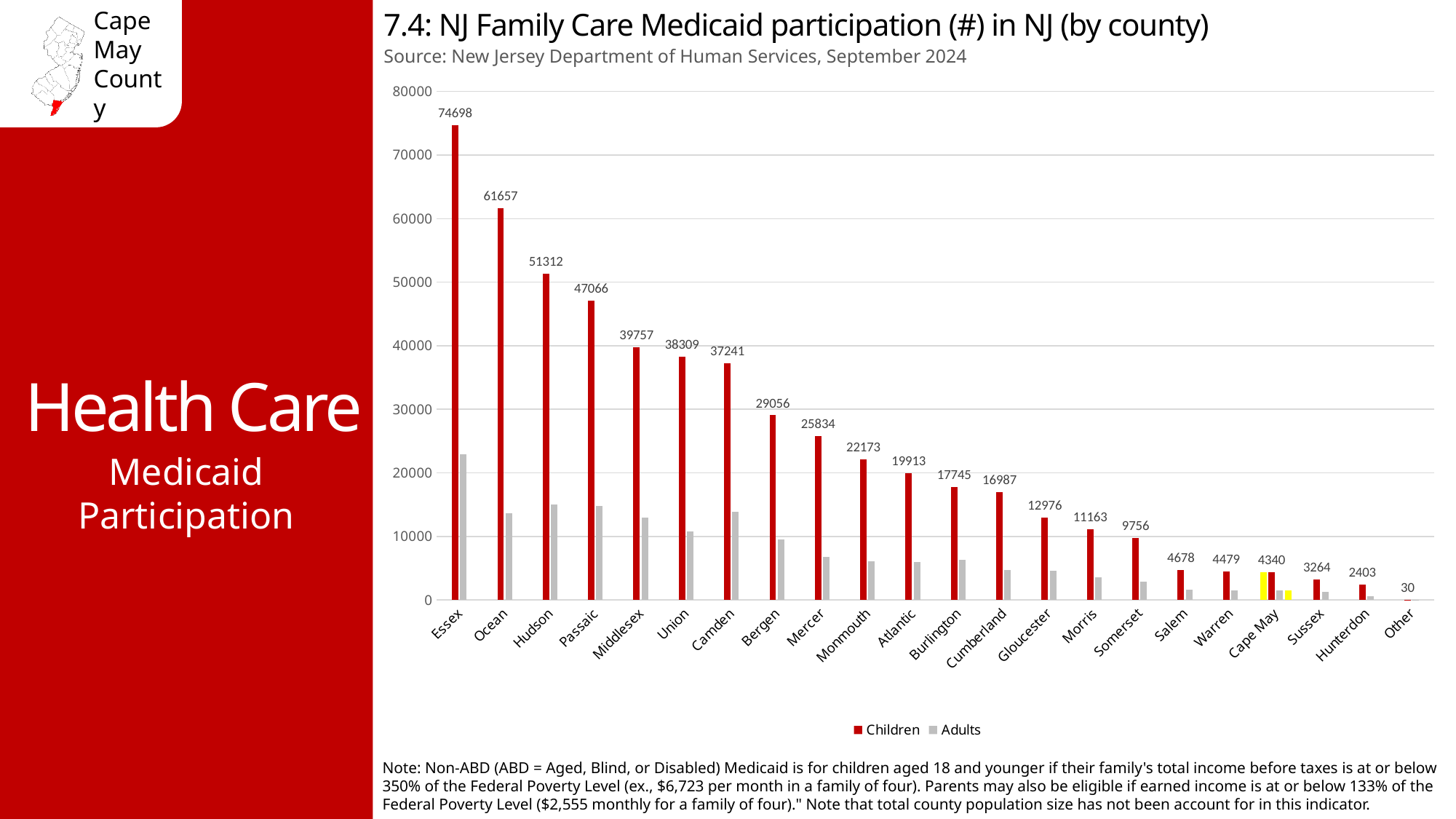
How many series does the legend list? 2 Which has a larger Children value, Bergen or Mercer? Bergen Is the Adults value for Ocean greater or less than 20000? less What is the Children value for Cape May? 4340 What kind of chart is shown? Bar chart What is the Children value for Essex? 74698 Is the Adults value for Essex greater or less than 20000? greater Which category has the lowest Children value? Other How many categories are shown on the x axis? 22 What is the difference between the Children values for Essex and Ocean? 13041 Which county has the highest Children value? Essex What is the Children value for Hudson? 51312